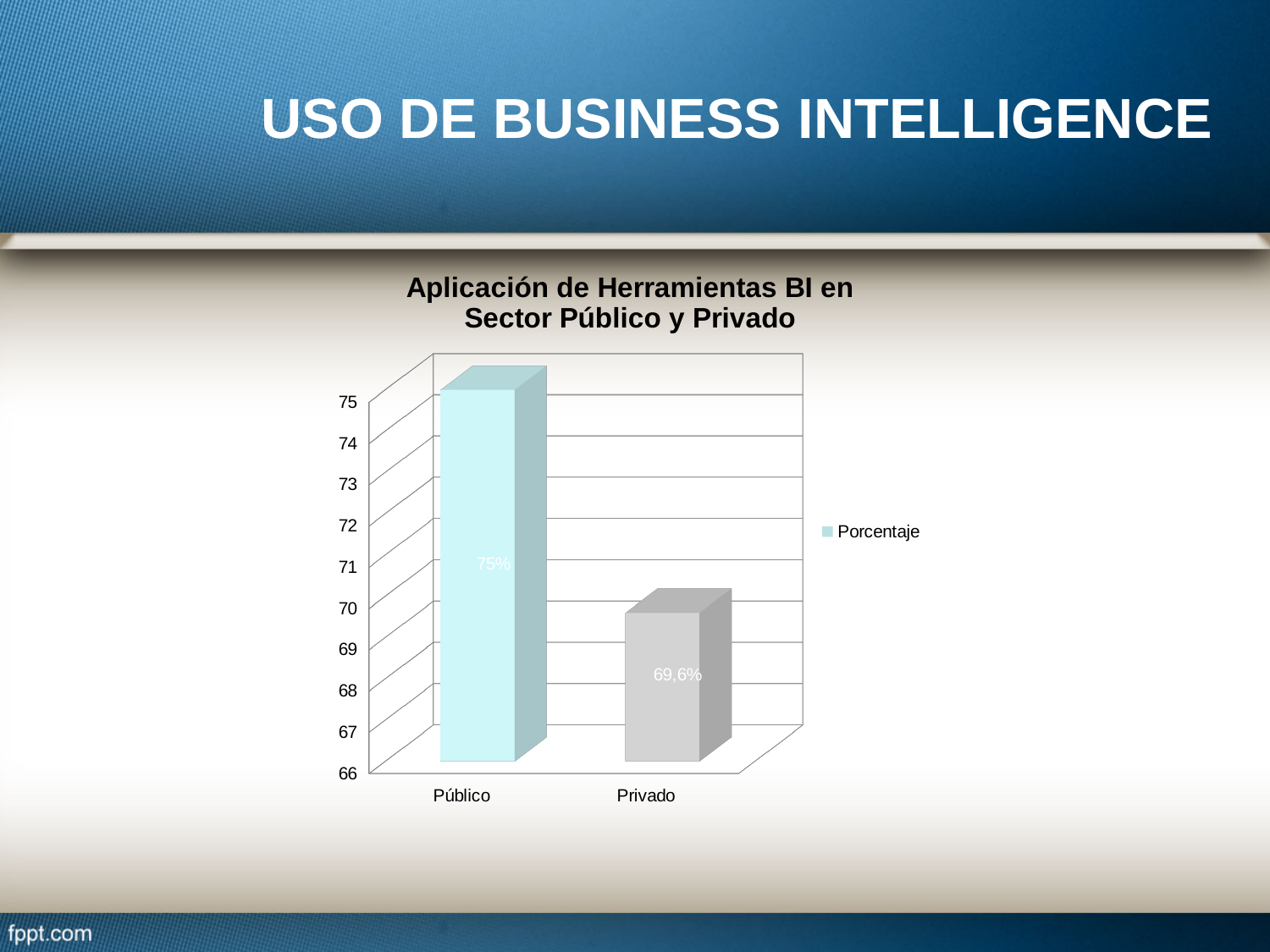
How many categories are shown on the x axis? 2 What is the difference between the values for Público and Privado? 5,4% How many series does the legend list? 1 What kind of chart is shown on the slide? bar chart What is the value for Privado? 69,6% What is the value for Público? 75% What is the title of the chart? Aplicación de Herramientas BI en Sector Público y Privado What is the name of the series listed in the legend? Porcentaje Which is larger, the value for Público or the value for Privado? Público Which category has the lowest value? Privado Is the value for Privado greater or less than 70? less Which category has the highest value? Público